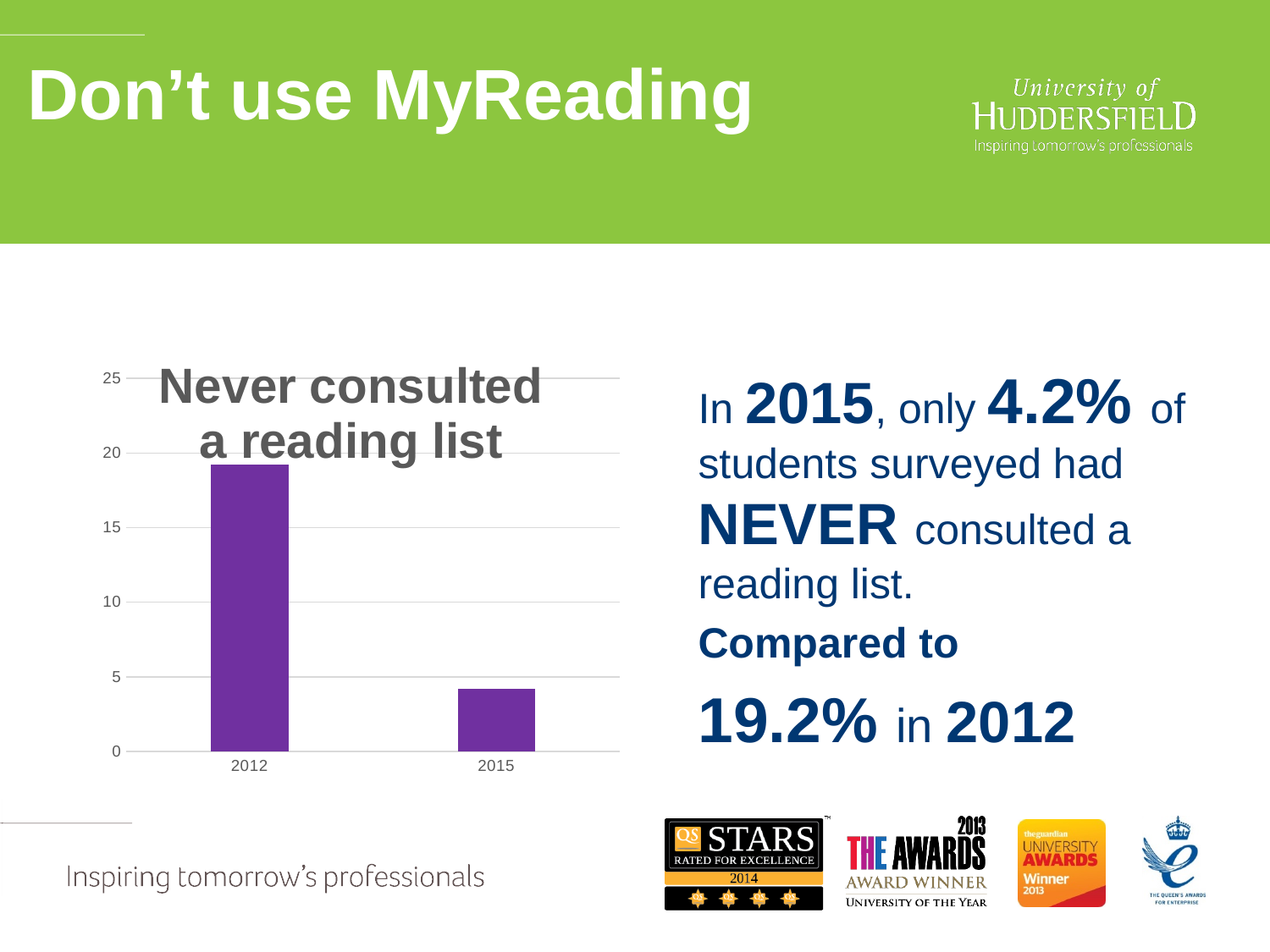
Which bar is taller, 2012 or 2015? 2012 Which year has the lowest bar in the chart? 2015 According to the slide, what percentage of students surveyed had never consulted a reading list in 2015? 4.2% According to the slide, what percentage of students surveyed had never consulted a reading list in 2012? 19.2% What kind of chart is shown on the slide? Bar chart What colour are the bars in the chart? Purple Which year has the highest bar in the chart? 2012 Is the value for 2015 greater or less than 5? less What is the title of the chart? Never consulted a reading list How many categories are plotted on the x axis of the chart? 2 Do the values rise or fall from 2012 to 2015? fall Is the value for 2012 greater or less than 15? greater